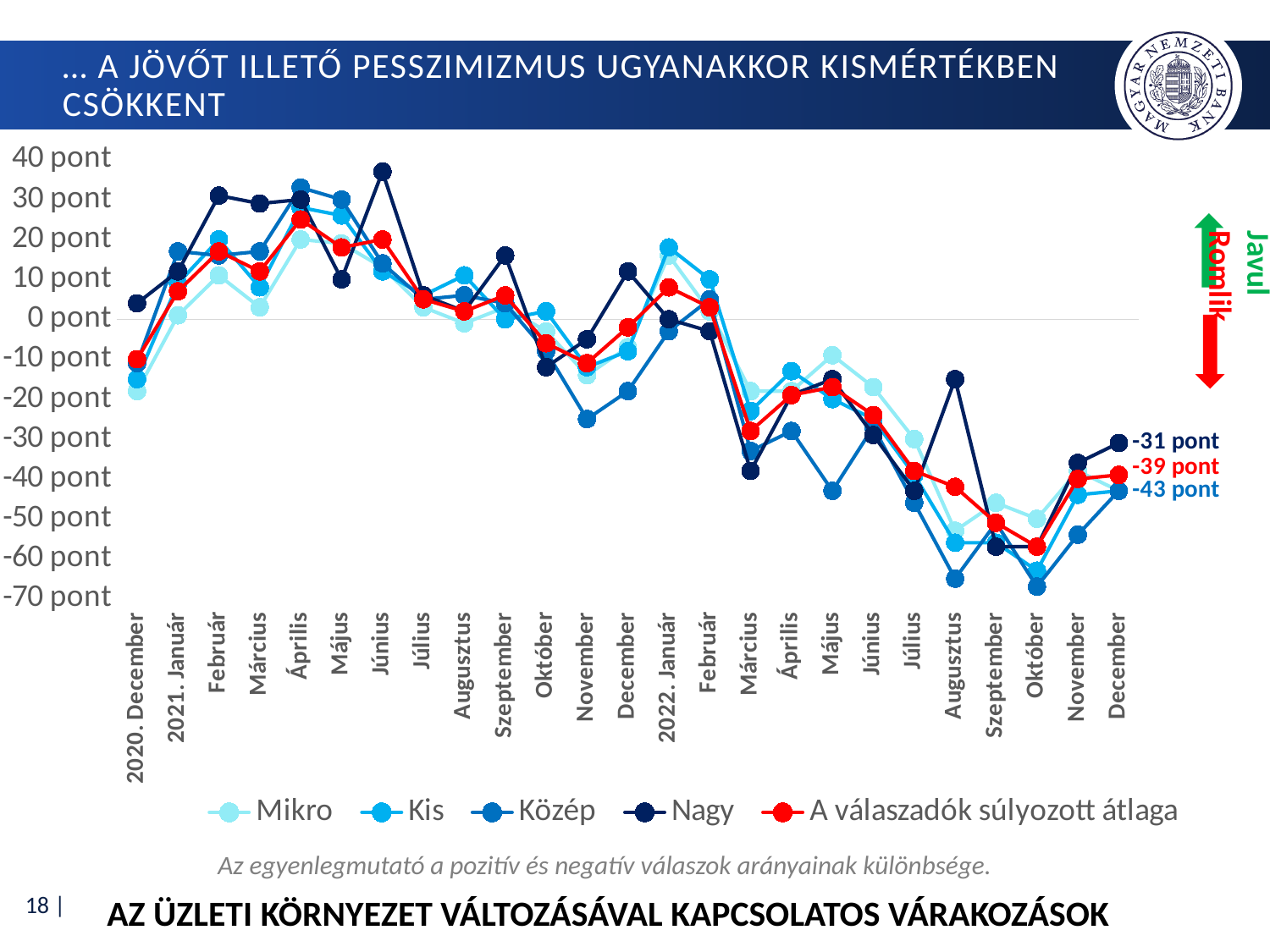
What is the difference between the labelled end values of Nagy (-31 pont) and the weighted average (-39 pont)? 8 pont How many series does the legend list? 5 Which series is listed last in the legend? A válaszadók súlyozott átlaga Does the weighted average ('A válaszadók súlyozott átlaga') rise or fall overall from 2021 Április to December 2022? fall Is the value for Nagy in 2021 Június greater or less than 30 pont? greater Is the value for Közép in 2022 Október greater or less than -60 pont? less What is the lowest value labelled at the right end of the chart? -43 pont How many months (points) are shown along the x axis? 25 What is the labelled value for 'A válaszadók súlyozott átlaga' at the last point (December 2022)? -39 pont What is the labelled value for the Nagy series at the last point (December 2022)? -31 pont At December 2022, which is larger: the Nagy value or the weighted average value? Nagy What kind of chart is shown on the slide? line chart